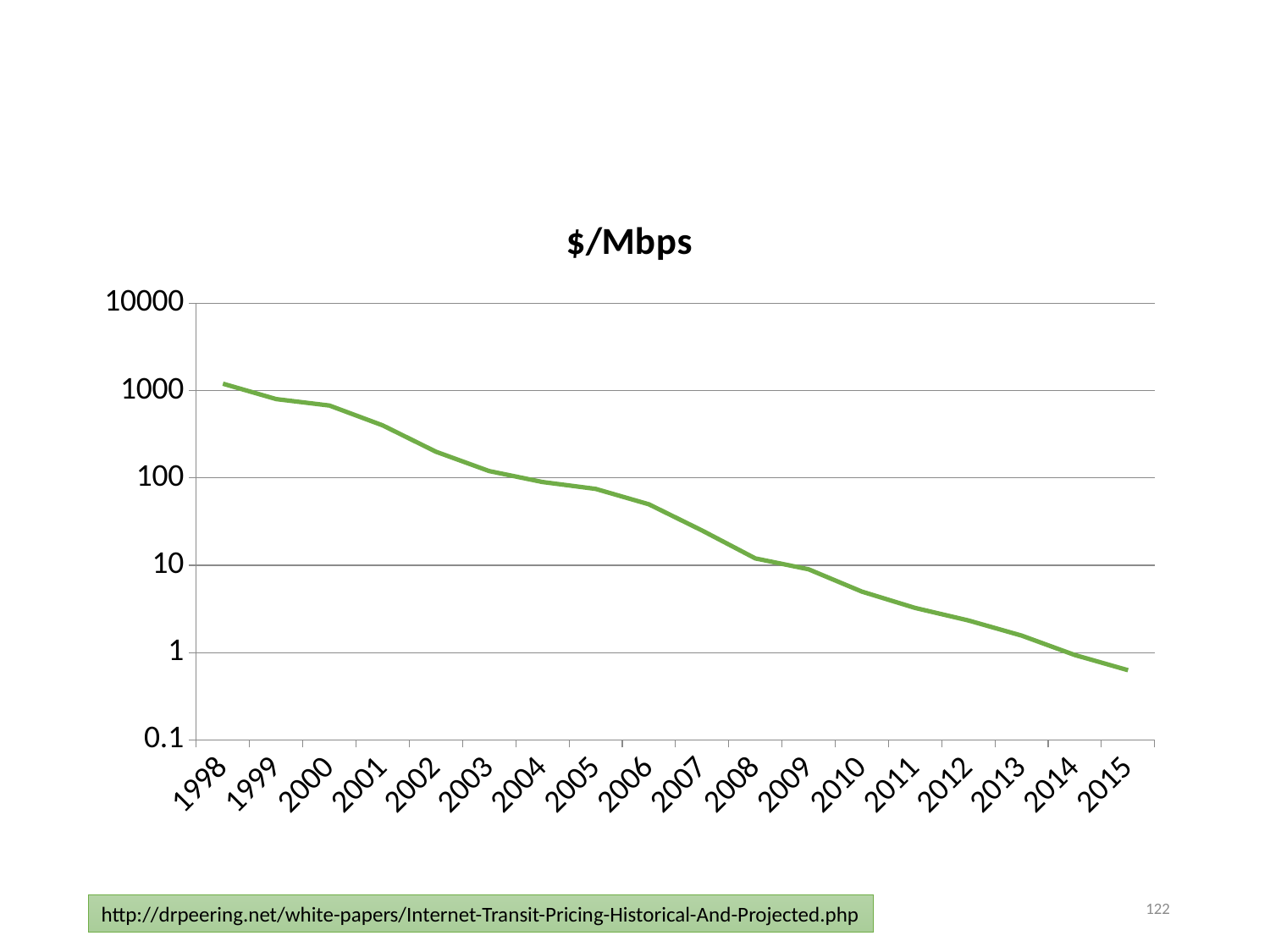
Which year has the highest value? 1998 Is the value for 2002 greater or less than 100? greater What kind of chart is shown on the slide? line chart Which is larger, the value for 2001 or the value for 2005? 2001 How many years are plotted along the x axis? 18 Is the value for 2015 greater or less than 1? less Is the value for 2007 greater or less than 10? greater Which year has the lowest value? 2015 What is the title of the chart? $/Mbps Do the values rise or fall from 1998 to 2015? fall